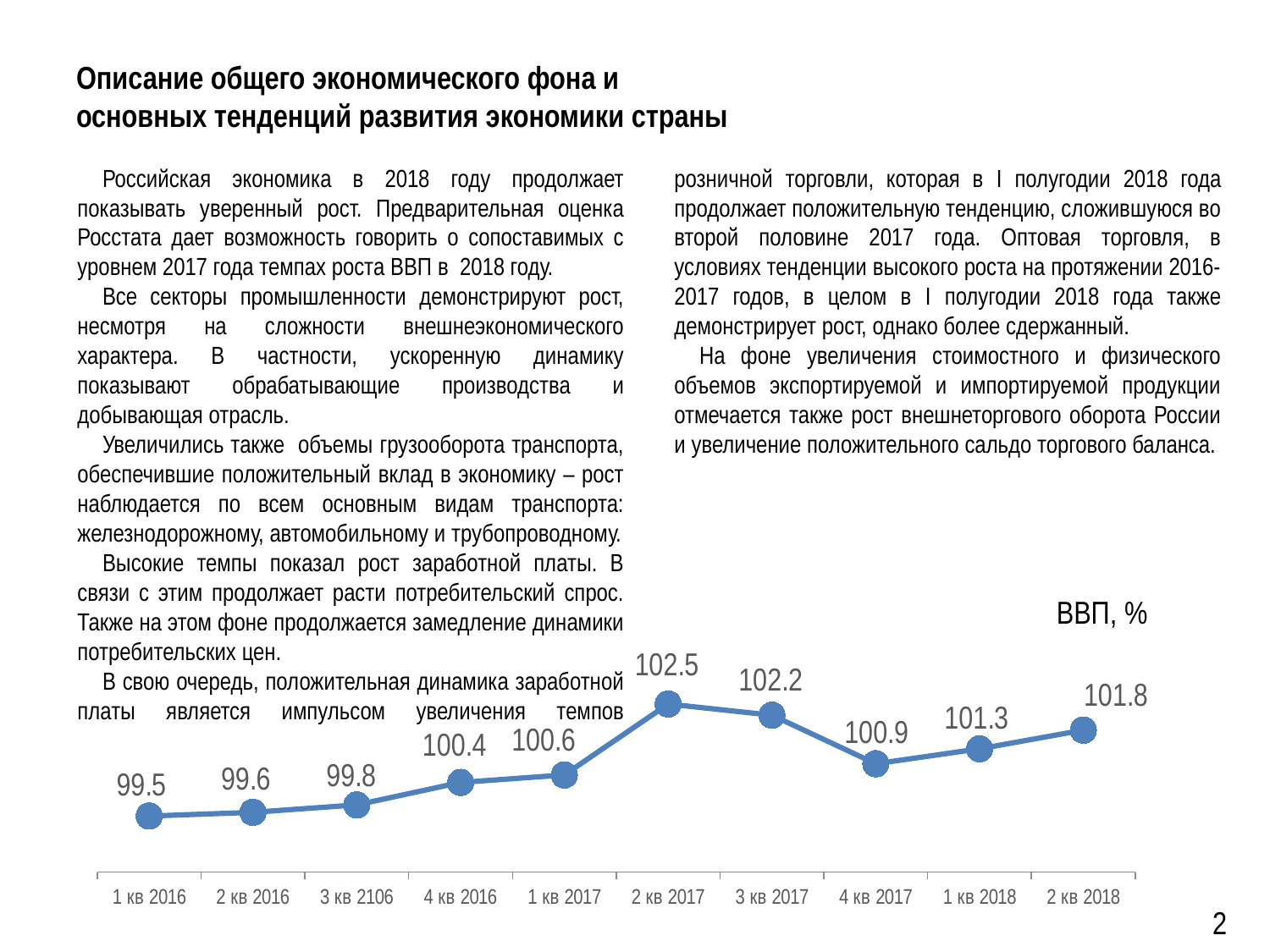
Do the values on the ВВП, % chart rise or fall from 1 кв 2016 to 2 кв 2017? rise Which quarter has the highest value on the ВВП, % chart? 2 кв 2017 What is the value for 4 кв 2017 on the ВВП, % chart? 100.9 What is the value for 2 кв 2017 on the ВВП, % chart? 102.5 What is the value for 2 кв 2018 on the ВВП, % chart? 101.8 Which quarter has the lowest value on the ВВП, % chart? 1 кв 2016 What is the difference between the values for 2 кв 2018 and 1 кв 2018 on the ВВП, % chart? 0.5 What is the difference between the values for 2 кв 2017 and 1 кв 2017 on the ВВП, % chart? 1.9 What is the value for 1 кв 2016 on the ВВП, % chart? 99.5 What type of chart is the ВВП, % chart? line chart How many data points are plotted on the ВВП, % chart? 10 Which is larger on the ВВП, % chart: the value for 3 кв 2017 or the value for 4 кв 2017? 3 кв 2017